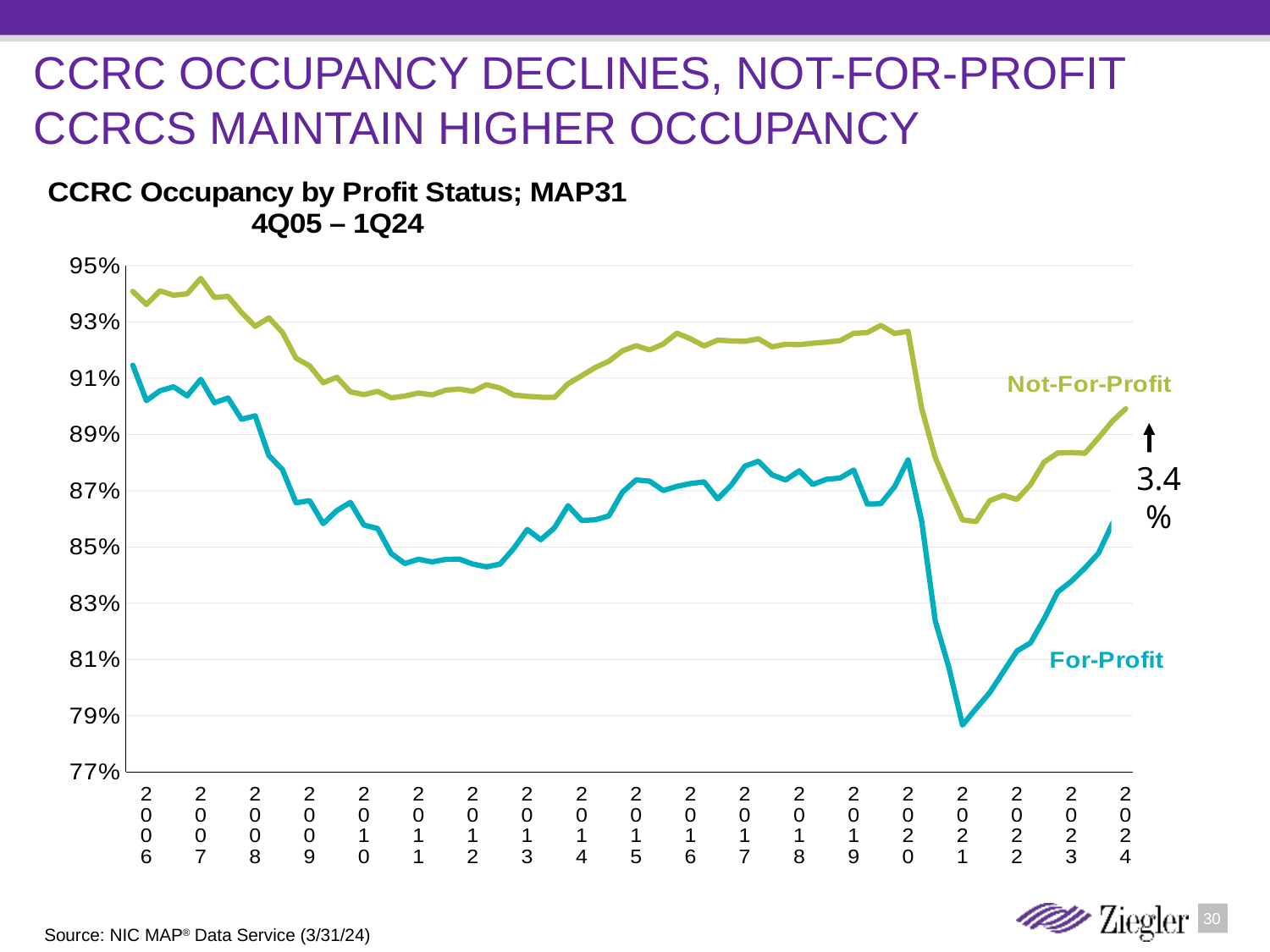
What is the title of the chart? CCRC Occupancy by Profit Status; MAP31 4Q05 – 1Q24 In which year does the For-Profit series reach its lowest point? 2021 What kind of chart is shown on the slide? Line chart Is the For-Profit occupancy in 2021 greater or less than 81%? less Does the For-Profit occupancy rise or fall from 2021 to 2024? Rise Is the Not-For-Profit occupancy in 2007 greater or less than 93%? greater Is the Not-For-Profit occupancy in 2021 greater or less than 87%? less How many series are plotted on the chart? 2 Which series has the higher occupancy in 2020, Not-For-Profit or For-Profit? Not-For-Profit Does the Not-For-Profit occupancy rise or fall from 2007 to 2012? Fall How many year labels are shown along the x axis? 19